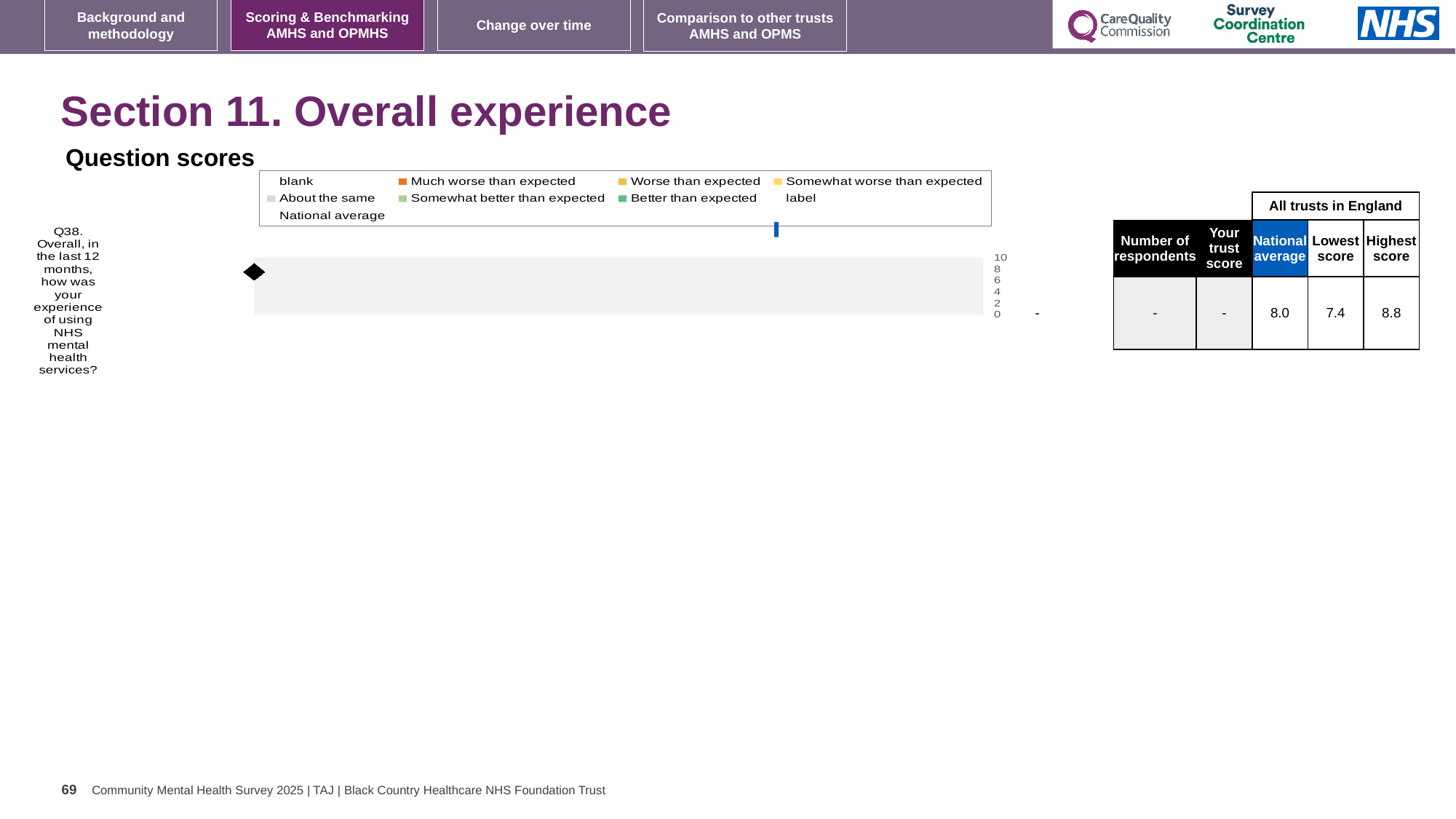
In the table next to the chart, what is shown as the number of respondents for Q38? - In the table next to the chart, what is the difference between the highest score and the lowest score for Q38? 1.4 In the table next to the chart, what is the national average score for Q38? 8.0 In the table next to the chart, what is the highest score among all trusts in England for Q38? 8.8 Which question is shown as the category label on the chart? Q38. Overall, in the last 12 months, how was your experience of using NHS mental health services? In the table next to the chart, what is the lowest score among all trusts in England for Q38? 7.4 What kind of chart is shown under 'Question scores'? bar chart What is the highest tick value shown on the chart's numeric axis? 10 In the table next to the chart, is the national average for Q38 greater or less than the lowest score? greater How many categories (questions) does the chart plot? 1